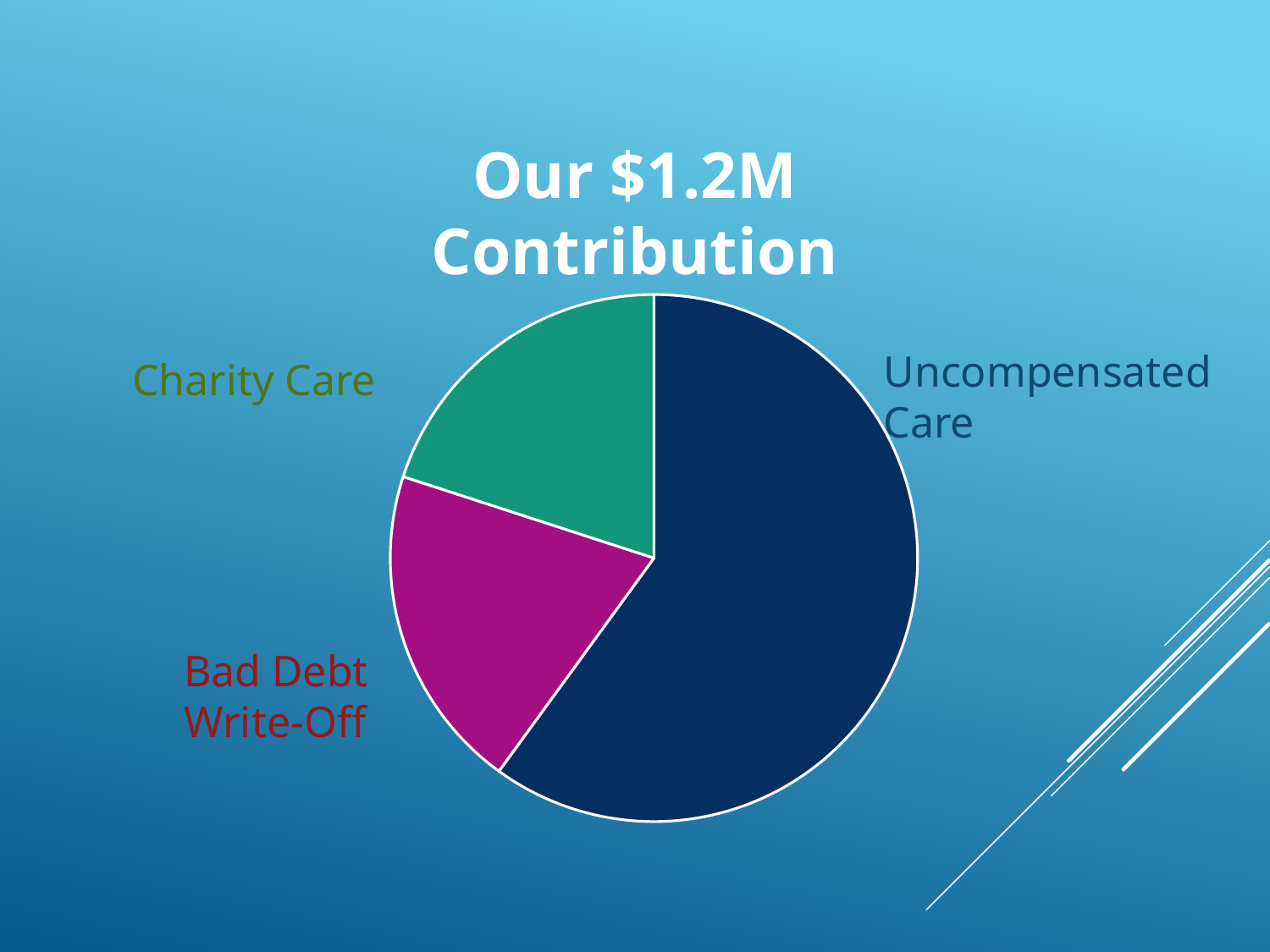
What colour is the Bad Debt Write-Off slice? Magenta What kind of chart is shown on the slide? Pie chart Which category has the largest slice of the pie? Uncompensated Care Which slice is larger, Uncompensated Care or Bad Debt Write-Off? Uncompensated Care How many slices does the pie chart have? 3 Is the Uncompensated Care slice more or less than half of the pie? more Which slice is larger, Uncompensated Care or Charity Care? Uncompensated Care What is the title of the chart? Our $1.2M Contribution